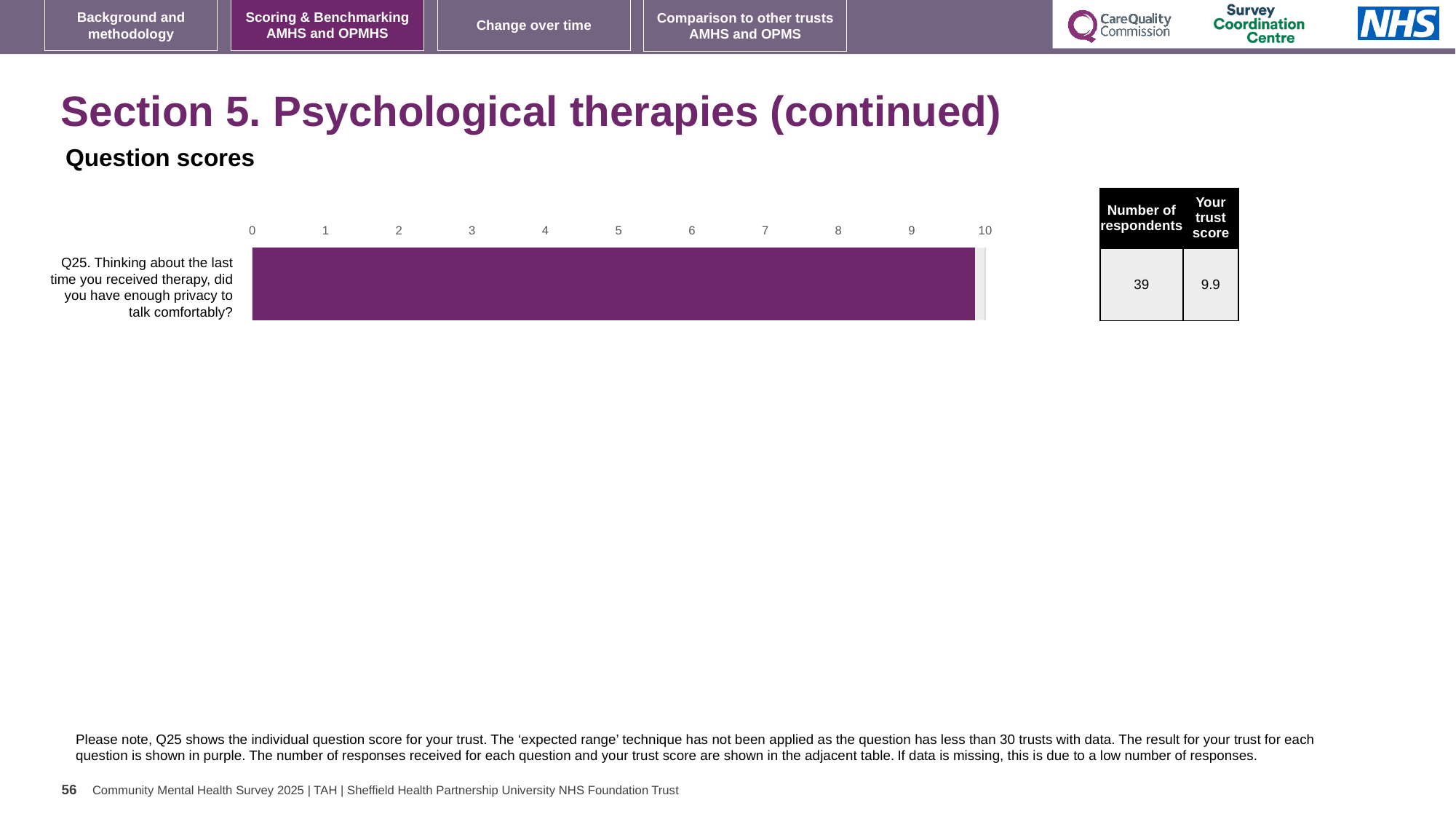
What colour is the bar for Q25? Purple Is the value for Q25 greater or less than 9? greater Which question is plotted in the chart? Q25. Thinking about the last time you received therapy, did you have enough privacy to talk comfortably? What kind of chart is shown on the slide? Bar chart How many questions (categories) are plotted in the chart? 1 What is the trust score for Q25 shown in the adjacent table? 9.9 What is the maximum value shown on the chart's axis? 10 Is the value for Q25 greater or less than 5? greater How many respondents answered Q25 according to the table? 39